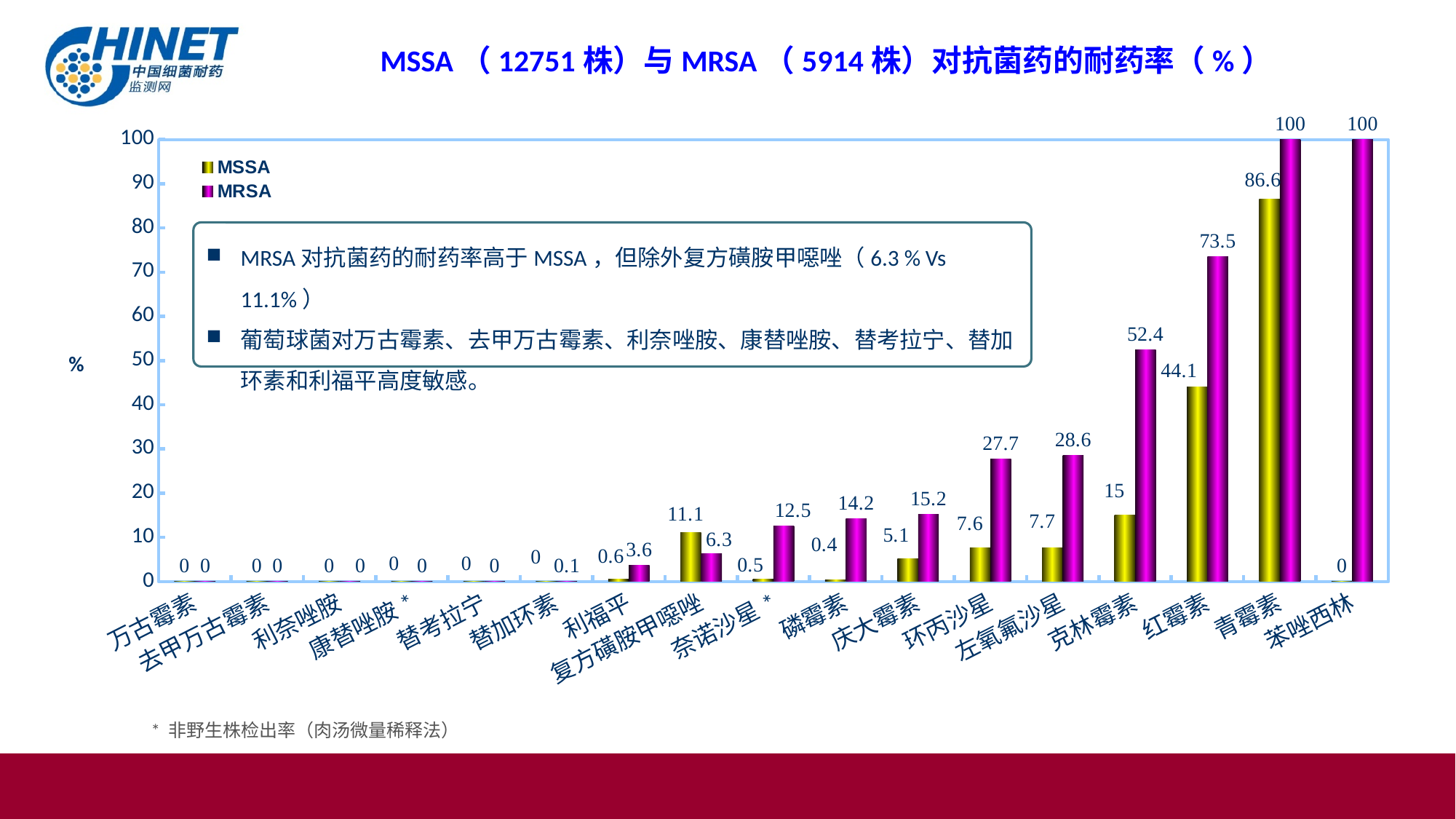
What is the difference between the MRSA and MSSA resistance rates for 红霉素? 29.4 What is the MSSA resistance rate for 克林霉素? 15 How many series does the legend list? 2 Is the MRSA resistance rate for 环丙沙星 greater or less than 20? greater Which antibiotic has the highest MSSA resistance rate? 青霉素 What is the MSSA resistance rate for 青霉素? 86.6 What kind of chart is shown on the slide? bar chart What is the MRSA resistance rate for 复方磺胺甲噁唑? 6.3 How many antibiotics are shown on the x axis? 17 What is the MRSA resistance rate for 红霉素? 73.5 For 复方磺胺甲噁唑, which is larger, the MSSA or the MRSA resistance rate? MSSA What is the difference between the MRSA and MSSA resistance rates for 克林霉素? 37.4